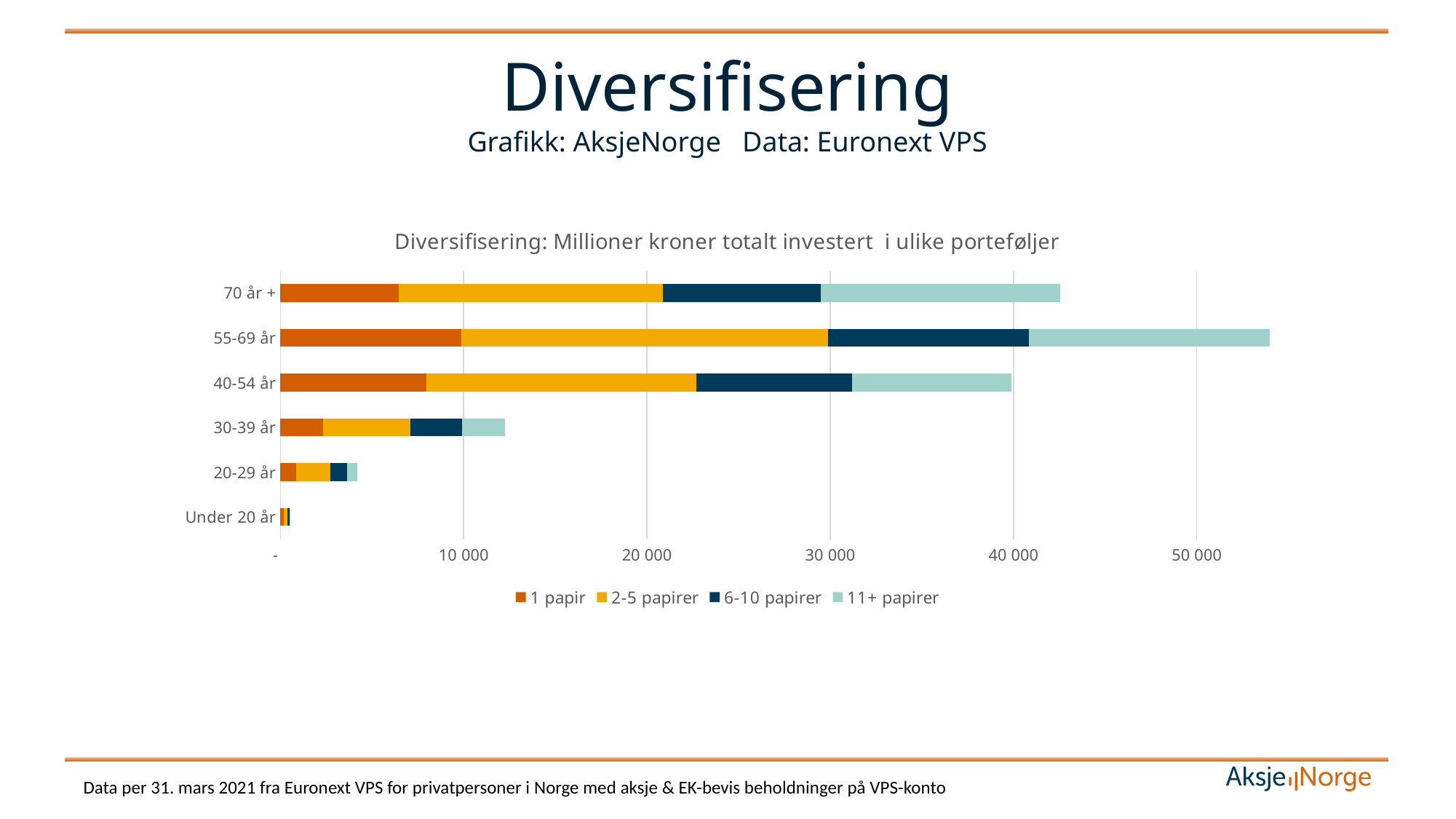
Is the total value for 20-29 år greater or less than 10 000? less How many series does the chart legend list? 4 What kind of chart is shown on the slide? Stacked bar chart What is the title of the chart? Diversifisering: Millioner kroner totalt investert i ulike porteføljer Which has a larger total bar, 55-69 år or 70 år +? 55-69 år Is the total value for 70 år + greater or less than 40 000? greater Which age category has the longest total bar? 55-69 år Which age category has the shortest total bar? Under 20 år Which series is shown in the lightest (teal) colour in the legend? 11+ papirer How many age categories are shown on the chart? 6 Is the total value for 30-39 år greater or less than 10 000? greater